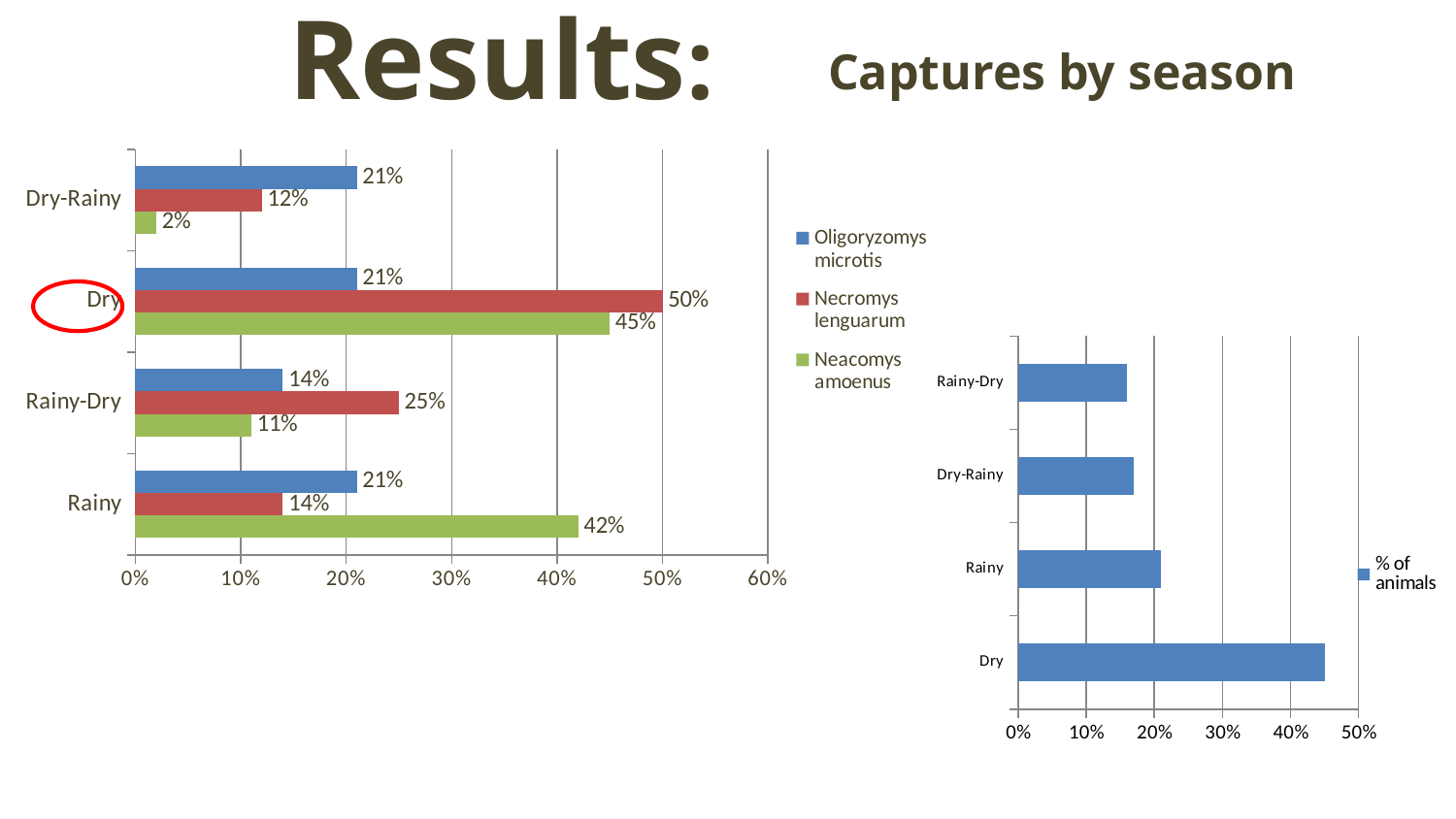
In the left chart, which season has the highest value for Necromys lenguarum? Dry In the left chart, which season has the lowest value for Neacomys amoenus? Dry-Rainy How many series does the legend of the left chart list? 3 In the left chart, what is the difference between Necromys lenguarum and Neacomys amoenus in the Rainy-Dry season? 14% In the left chart, which is larger in the Dry-Rainy season: Oligoryzomys microtis or Necromys lenguarum? Oligoryzomys microtis In the right chart, which season has the highest value? Dry In the right chart, is the value for Dry greater or less than 40%? greater How many seasons are shown on the right chart? 4 In the left chart, what is the value for Oligoryzomys microtis in the Rainy-Dry season? 14% What type of chart is the right chart? bar chart In the left chart, what is the value for Necromys lenguarum in the Dry season? 50% In the left chart, what is the value for Neacomys amoenus in the Rainy season? 42%